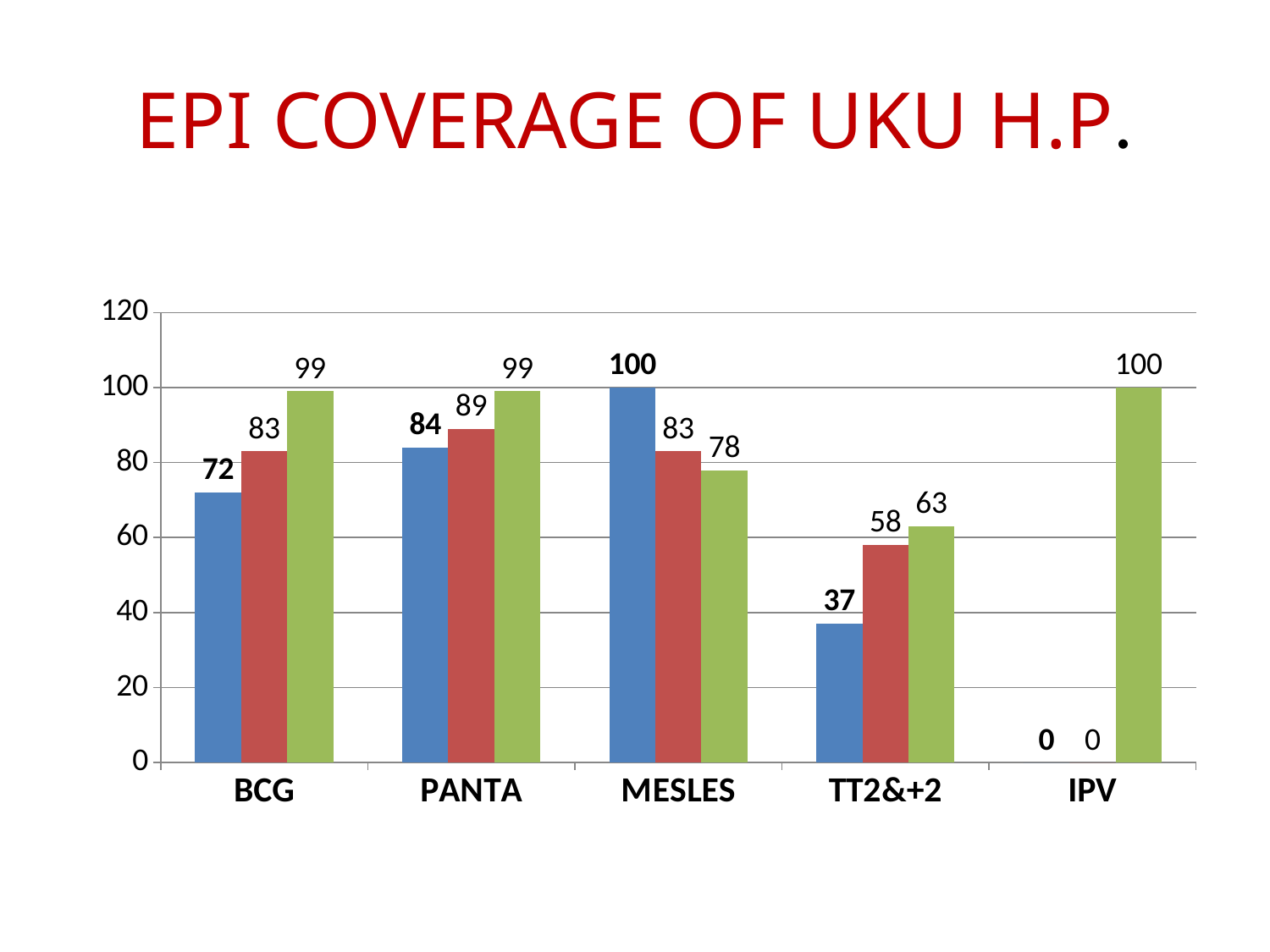
Which category has the highest blue bar? MESLES What is the value of the red bar for TT2&+2? 58 What kind of chart is shown on the slide? bar chart Which category has the lowest blue bar? IPV How many categories are shown on the x axis? 5 What is the difference between the green bar and the blue bar for BCG? 27 What is the value of the green bar for IPV? 100 What is the title of the slide? EPI COVERAGE OF UKU H.P. Which is larger for MESLES, the blue bar or the green bar? the blue bar What is the value of the green bar for PANTA? 99 What is the value of the blue bar for BCG? 72 What is the difference between the green bar and the red bar for TT2&+2? 5